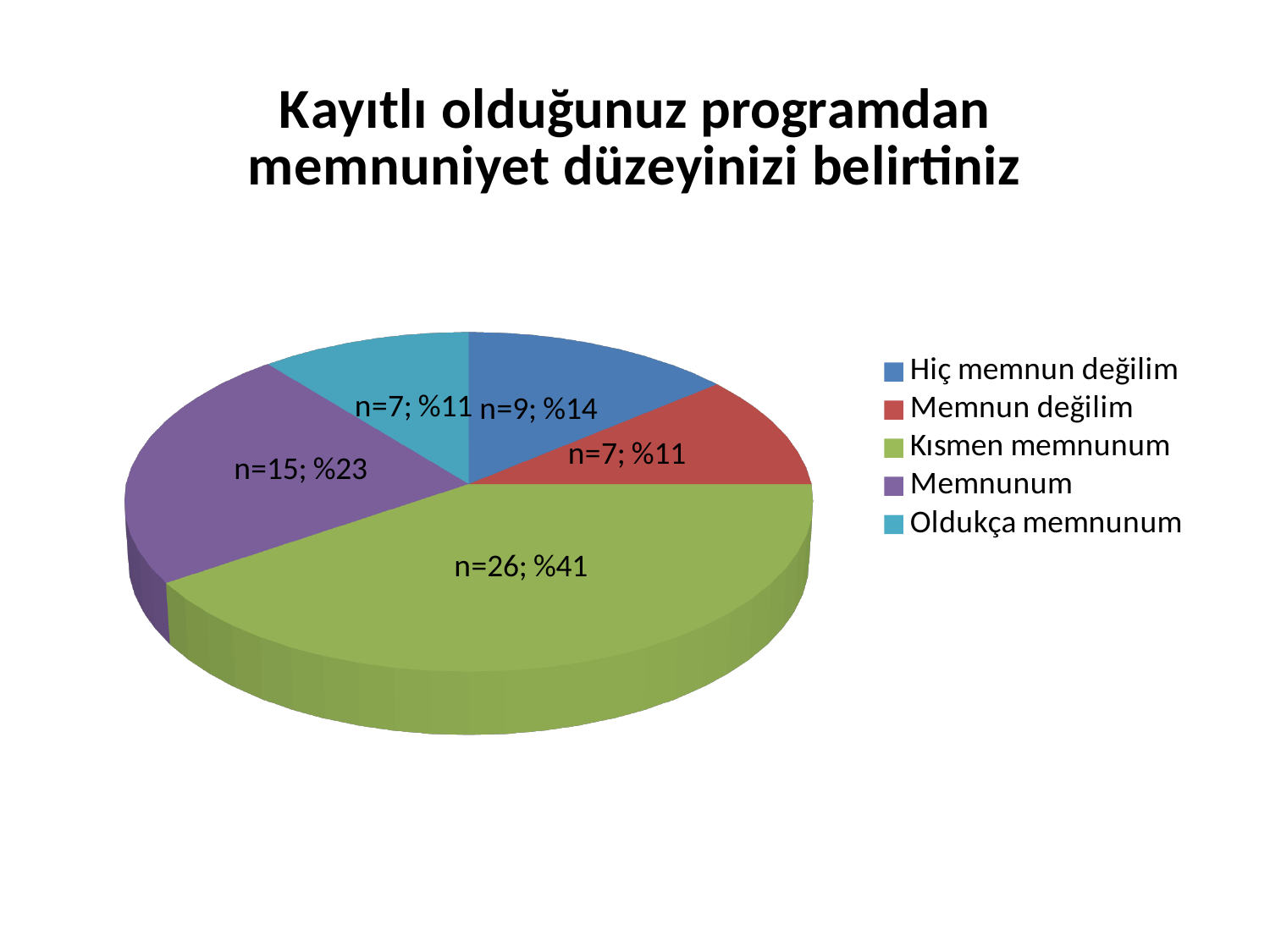
What kind of chart is shown on the slide? Pie chart What is the data label for the Hiç memnun değilim slice? n=9; %14 How many categories does the legend list? 5 What is the title of the chart? Kayıtlı olduğunuz programdan memnuniyet düzeyinizi belirtiniz What colour is the Kısmen memnunum slice? Green What percentage share does the Memnun değilim slice have? %11 Which category has the largest slice? Kısmen memnunum What percentage share does the Oldukça memnunum slice have? %11 What is the difference in n between Kısmen memnunum and Memnunum? 11 What is the data label for the Kısmen memnunum slice? n=26; %41 What is the data label for the Memnunum slice? n=15; %23 Which is larger, the Memnunum slice or the Hiç memnun değilim slice? Memnunum